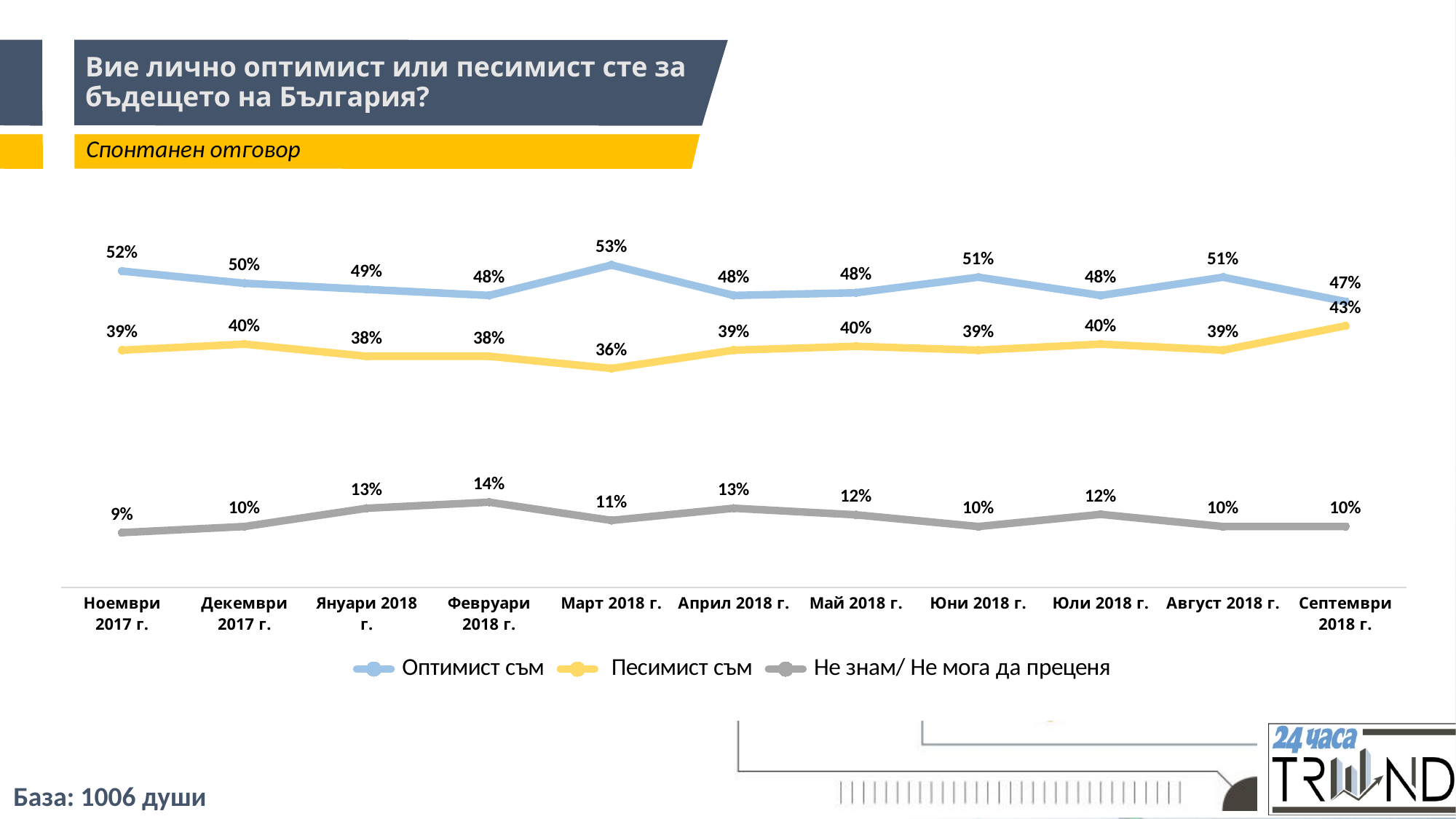
Which is larger in Ноември 2017 г.: "Оптимист съм" or "Песимист съм"? Оптимист съм What is the value for "Оптимист съм" in Март 2018 г.? 53% In which month does "Оптимист съм" reach its highest value? Март 2018 г. What is the value for "Песимист съм" in Септември 2018 г.? 43% How many series does the legend list? 3 In which month is "Не знам/ Не мога да преценя" lowest? Ноември 2017 г. What type of chart is shown on the slide? line chart What is the difference between "Оптимист съм" and "Песимист съм" in Септември 2018 г.? 4% What is the title of the chart on the slide? Вие лично оптимист или песимист сте за бъдещето на България? What is the value for "Не знам/ Не мога да преценя" in Февруари 2018 г.? 14% In which month does "Песимист съм" have its lowest value? Март 2018 г. How many time points are shown on the x axis? 11